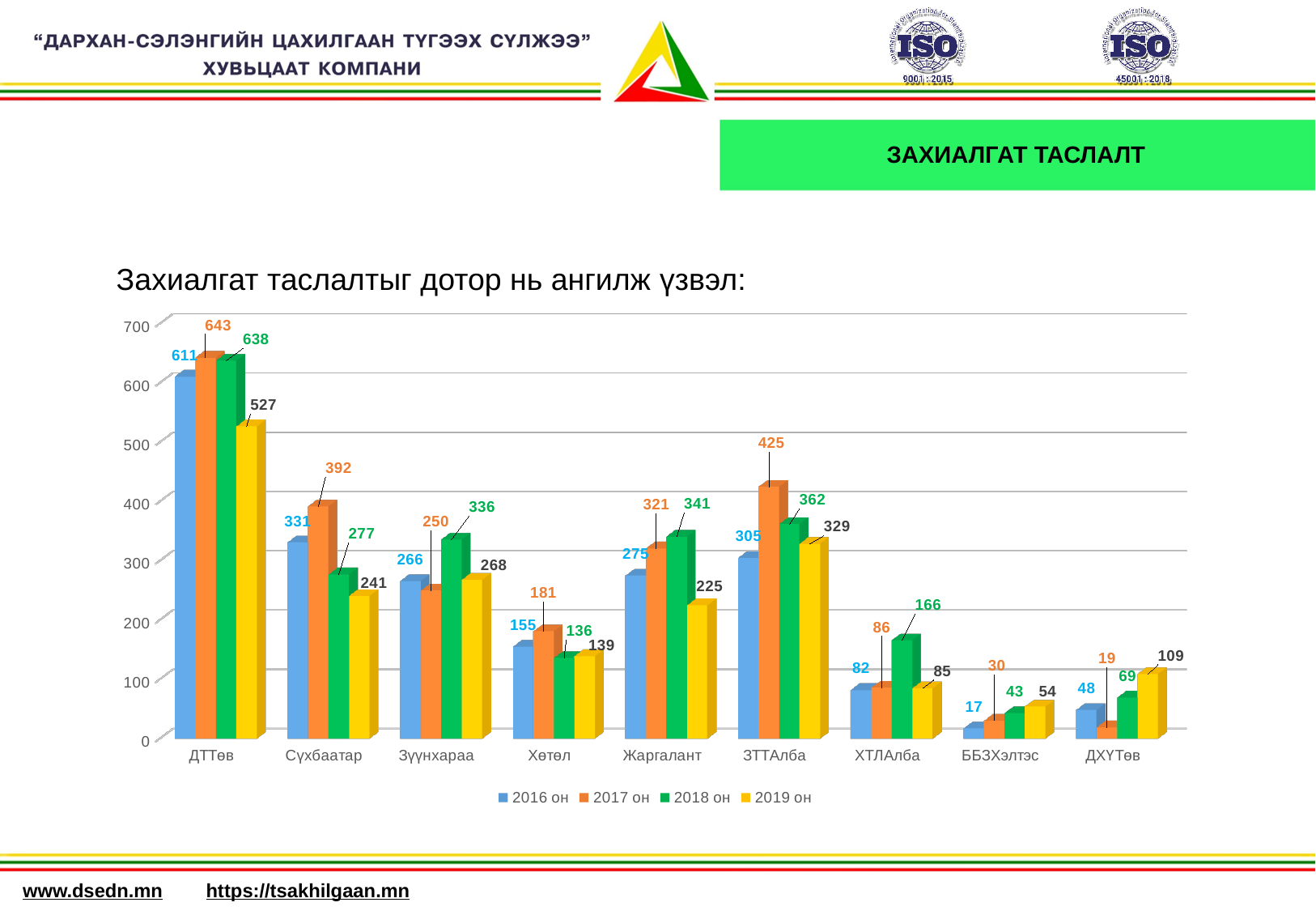
What is the value for Хөтөл in the 2018 он series? 136 Is the value for Жаргалант in the 2019 он series greater or less than 300? less Which is larger for Зүүнхараа: the 2016 он value or the 2018 он value? 2018 он Which category has the highest value in the 2016 он series? ДТТөв How many series does the legend list? 4 What is the value for ЗТТАлба in the 2019 он series? 329 Do the values for ББЗХэлтэс rise or fall from 2016 он to 2019 он? rise Which category has the lowest value in the 2017 он series? ДХҮТөв What is the value for ДТТөв in the 2017 он series? 643 What is the difference between the 2017 он and 2019 он values for Сүхбаатар? 151 How many categories are shown on the x axis? 9 What kind of chart is shown on the slide? bar chart